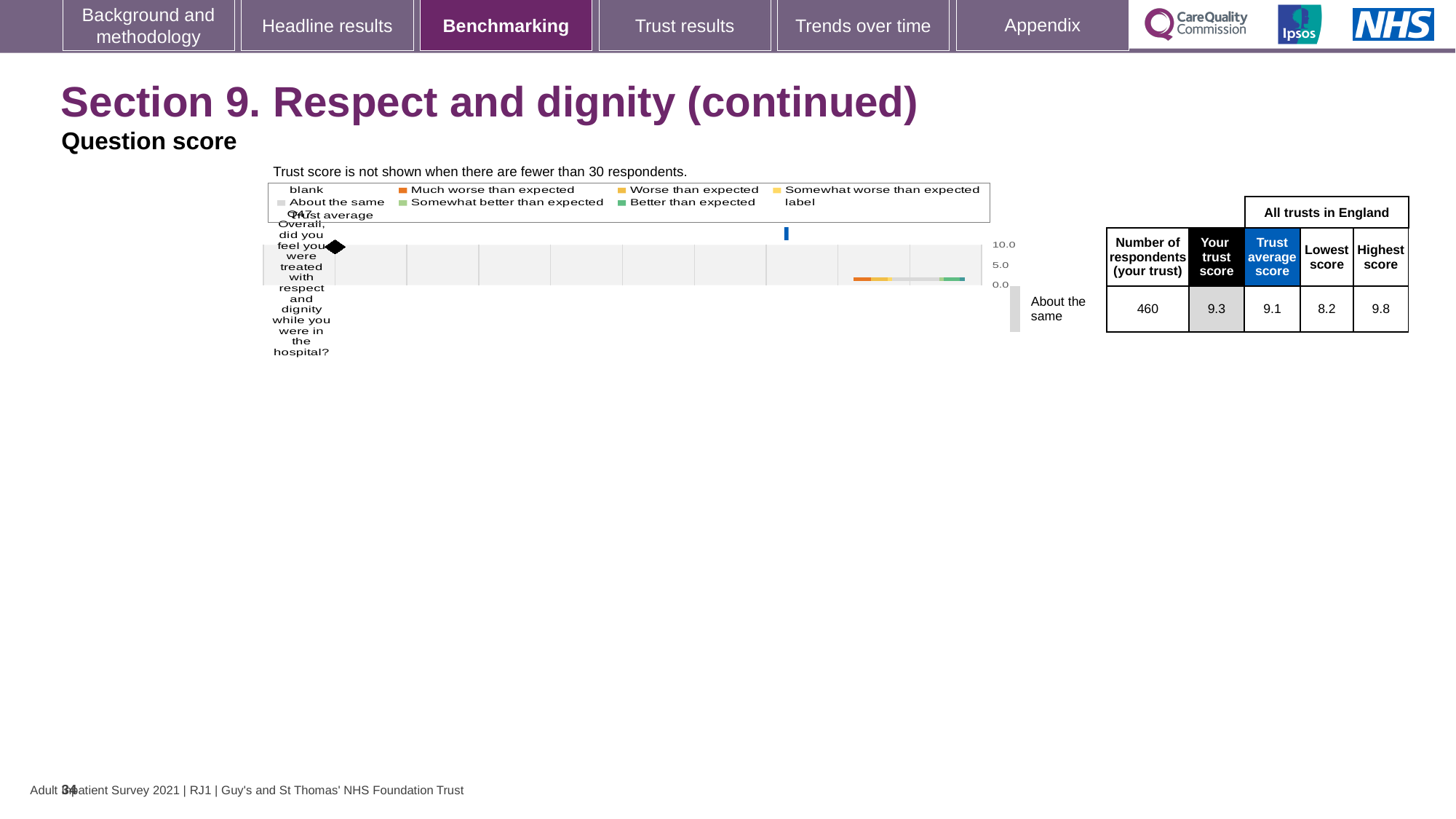
What is the difference between the highest score and the lowest score for the respect and dignity question? 1.6 What is the highest score among all trusts in England for the respect and dignity question? 9.8 Is the trust's score for the respect and dignity question higher or lower than the trust average score? higher What is the lowest score among all trusts in England for the respect and dignity question? 8.2 How many survey questions are plotted on the chart? 1 What is the trust's score for the question "Overall, did you feel you were treated with respect and dignity while you were in the hospital?"? 9.3 What is the maximum value shown on the chart's score axis? 10.0 What kind of chart is used to show the question score? bar chart By how much does the trust's score exceed the trust average score for the respect and dignity question? 0.2 Which benchmarking category is the trust's result for the respect and dignity question placed in? About the same What is the trust average score for the respect and dignity question? 9.1 How many respondents from the trust answered the respect and dignity question? 460